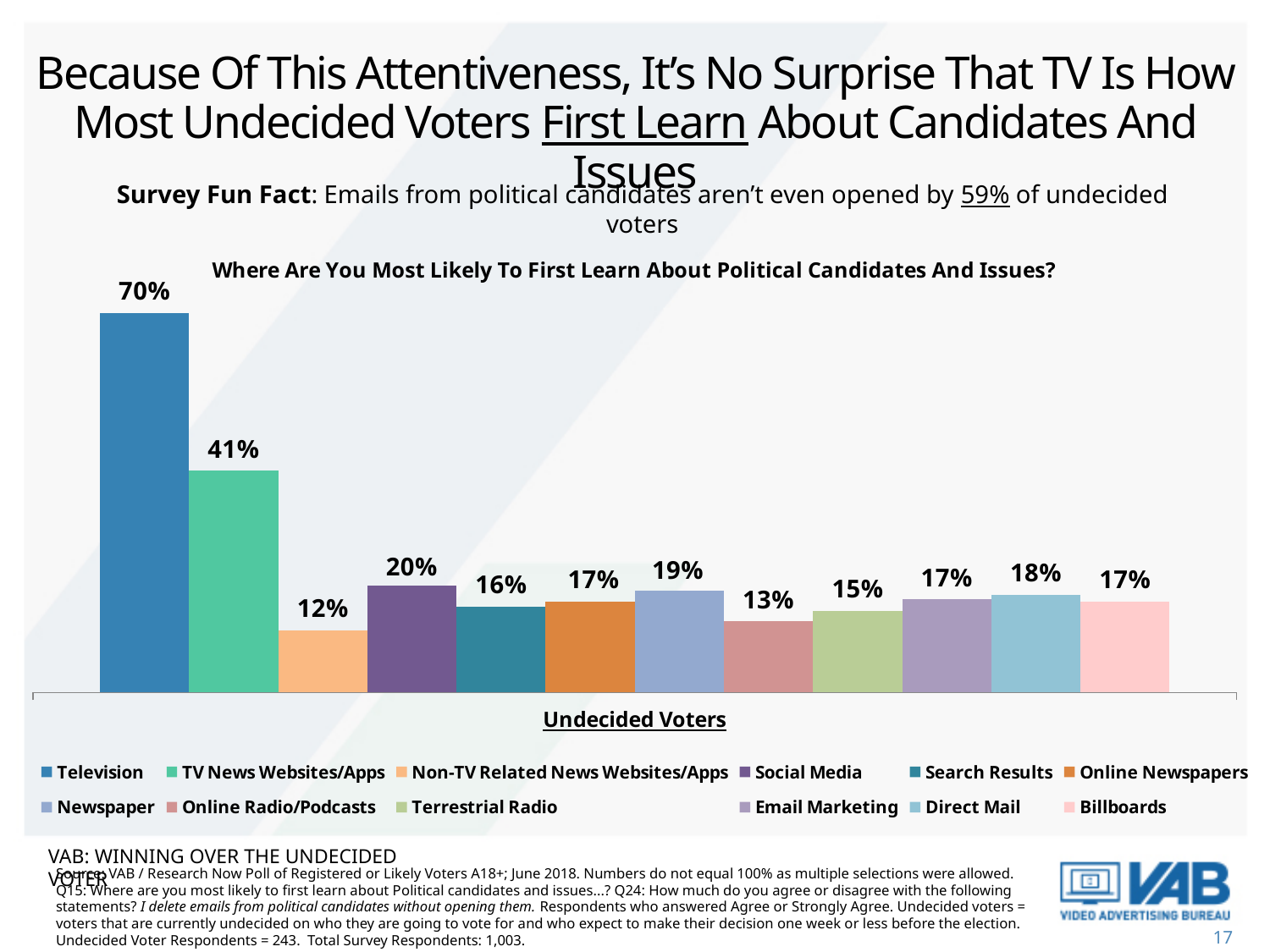
What percentage of undecided voters say Television is where they are most likely to first learn about political candidates and issues? 70% Which is larger, the value for Social Media or the value for Search Results? Social Media Which source has the lowest value in the chart? Non-TV Related News Websites/Apps How many series does the legend list? 12 What is the value for Direct Mail in the chart? 18% What is the difference between the values for Newspaper and Online Radio/Podcasts? 6% What is the value for TV News Websites/Apps in the chart? 41% Which source has the highest value in the chart? Television What kind of chart is shown on the slide? Bar chart What is the value for Social Media in the chart? 20% What is the difference between the values for Television and TV News Websites/Apps? 29% What is the title of the chart? Where Are You Most Likely To First Learn About Political Candidates And Issues?